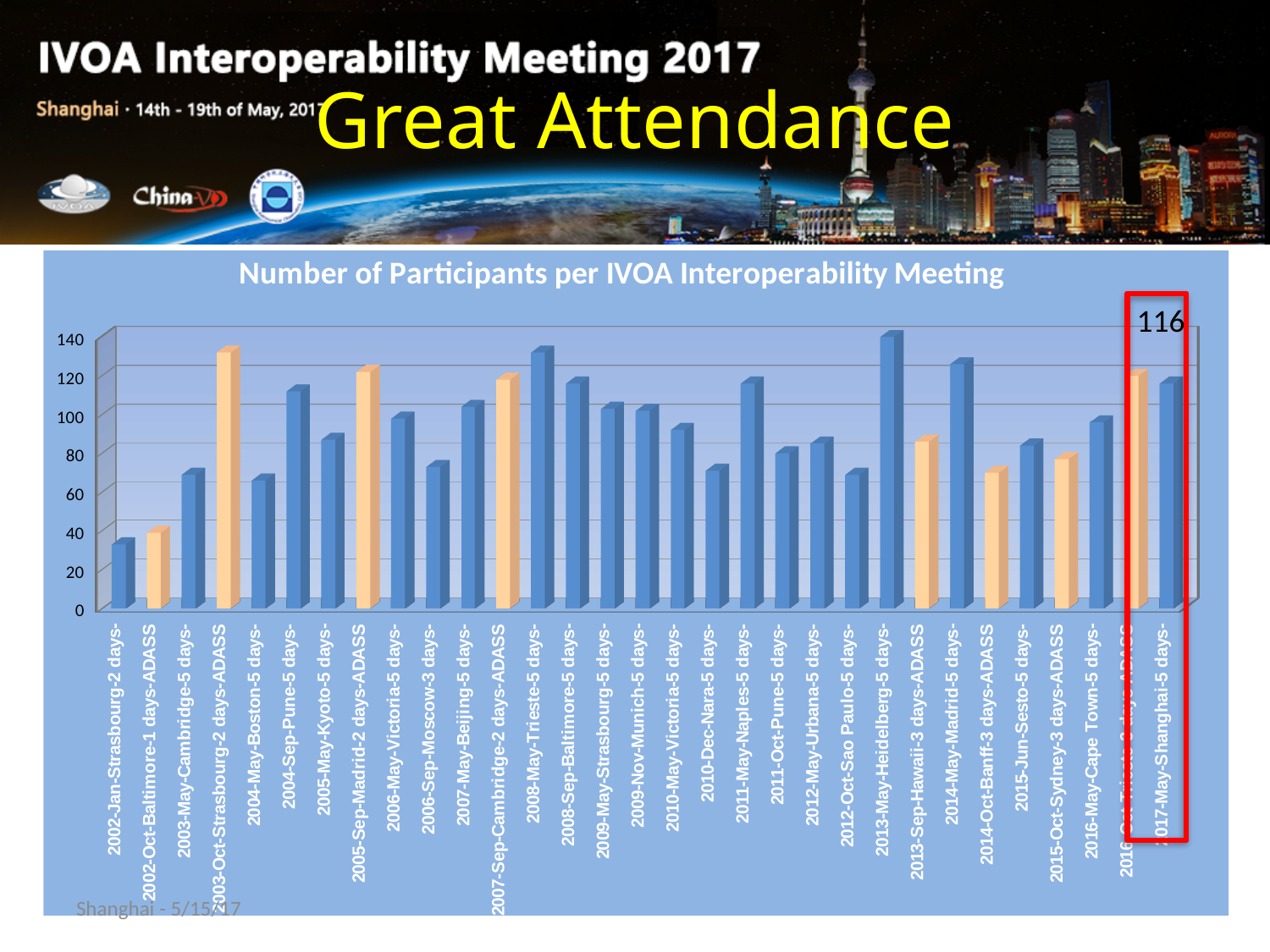
Is the value for 2002-Jan-Strasbourg-2 days greater or less than 40? less Which bar on the chart is highlighted with a red box? 2017-May-Shanghai-5 days Which meeting had the lowest number of participants? 2002-Jan-Strasbourg-2 days What is the title of the chart? Number of Participants per IVOA Interoperability Meeting Is the value for 2003-Oct-Strasbourg-2 days-ADASS greater or less than 120? greater Which had more participants, 2012-Oct-Sao Paulo-5 days or 2014-May-Madrid-5 days? 2014-May-Madrid-5 days How many participants attended the 2017-May-Shanghai-5 days meeting? 116 Is the value for 2006-Sep-Moscow-3 days greater or less than 80? less Which meeting had the highest number of participants? 2013-May-Heidelberg-5 days What kind of chart is shown on the slide? bar chart Which had more participants, 2008-May-Trieste-5 days or 2010-Dec-Nara-5 days? 2008-May-Trieste-5 days